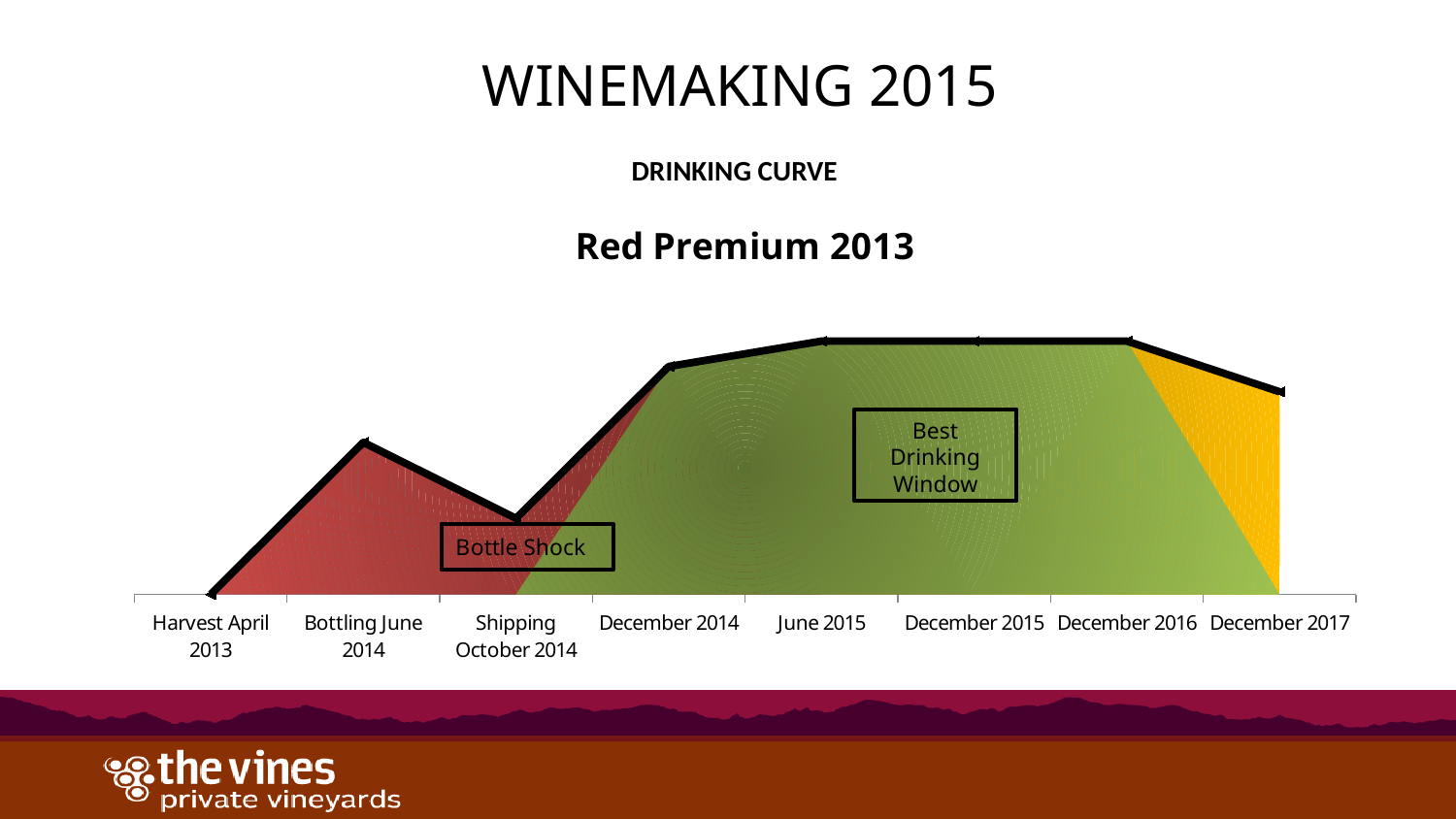
Which category on the x axis has the lowest value on the drinking curve? Harvest April 2013 Which is higher on the drinking curve, Bottling June 2014 or Shipping October 2014? Bottling June 2014 What is the title of the chart? Red Premium 2013 Does the drinking curve rise or fall from Shipping October 2014 to June 2015? rise Does the drinking curve rise or fall from Harvest April 2013 to Bottling June 2014? rise Does the drinking curve rise or fall from December 2016 to December 2017? fall Which is higher on the drinking curve, Shipping October 2014 or December 2014? December 2014 What kind of chart is shown on the slide? area chart What label is placed in the box near the dip at Shipping October 2014? Bottle Shock Which is higher on the drinking curve, December 2017 or Bottling June 2014? December 2017 How many categories are shown along the x axis of the chart? 8